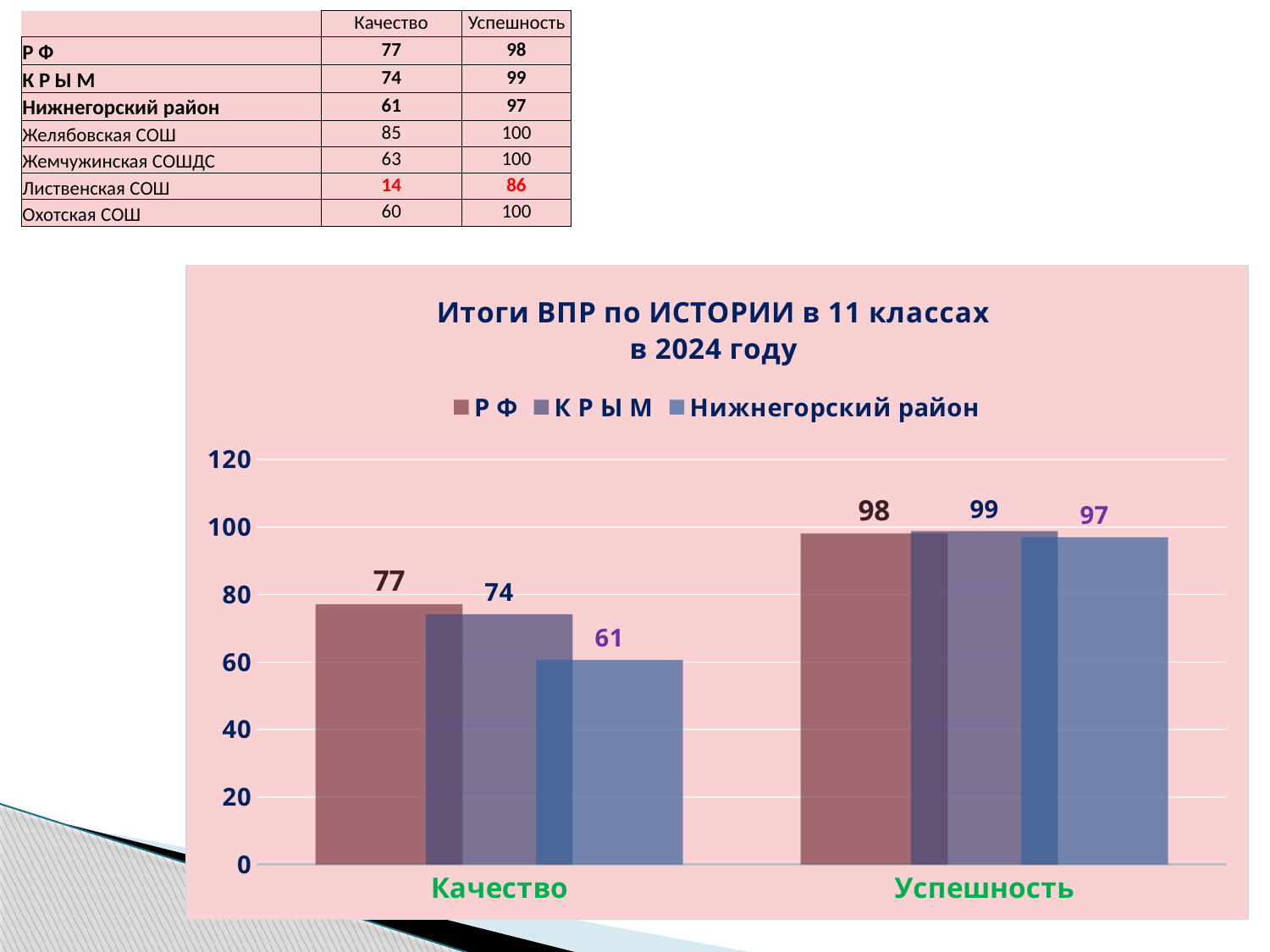
What is the value for Нижнегорский район in the Успешность category? 97 What is the value for К Р Ы М in the Качество category? 74 How many categories are shown on the x axis of the chart? 2 What is the value for Нижнегорский район in the Качество category? 61 Which series has the lowest value in the Качество category? Нижнегорский район Which is larger in the Качество category: the value for Р Ф or the value for К Р Ы М? Р Ф What type of chart is shown on the slide? Bar chart What is the value for Р Ф in the Успешность category? 98 What is the value for К Р Ы М in the Успешность category? 99 What is the difference between the Р Ф and Нижнегорский район values in the Качество category? 16 What is the value for Р Ф in the Качество category? 77 How many series does the chart legend list? 3